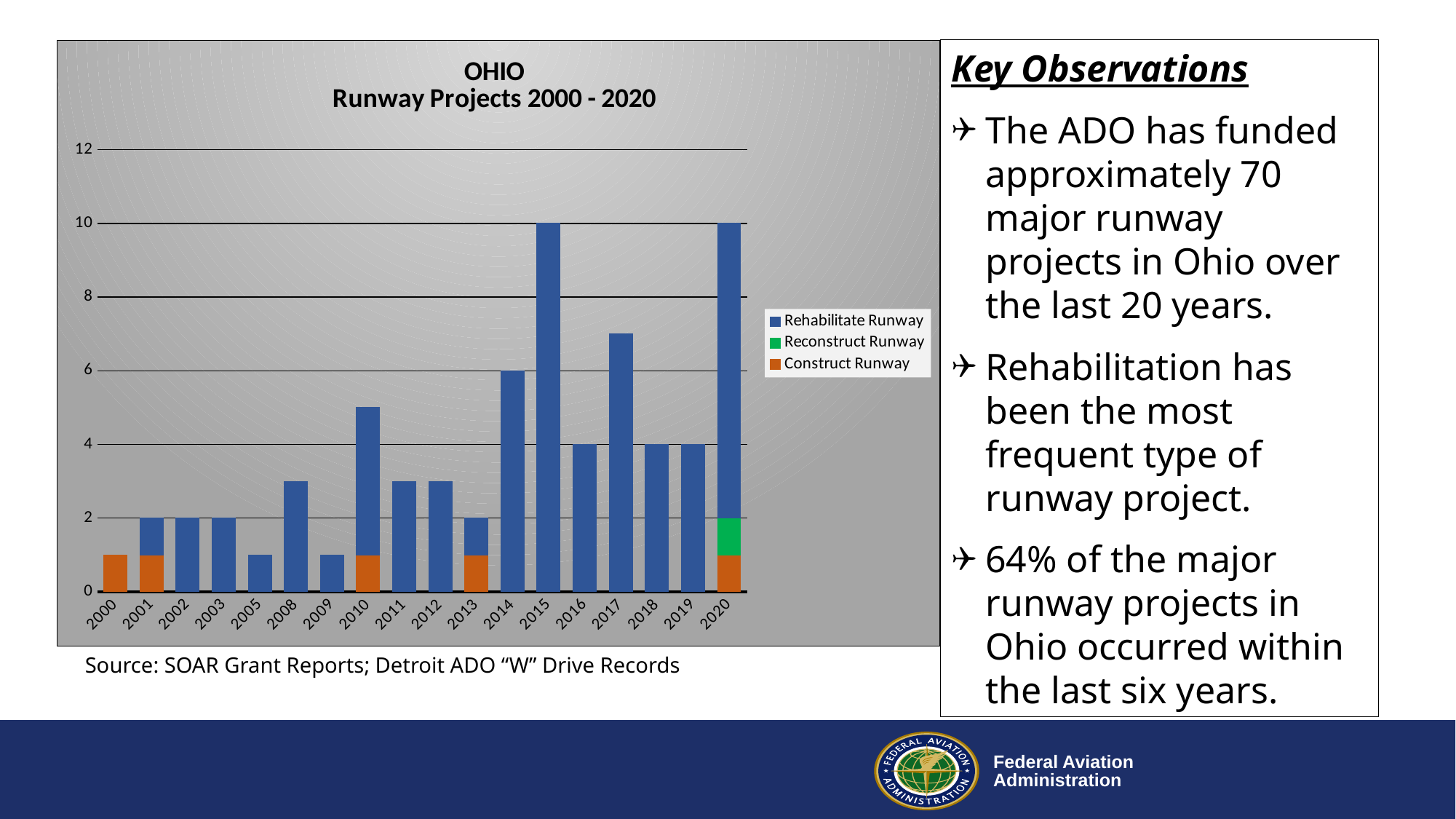
What is the title of the chart? OHIO Runway Projects 2000 - 2020 What is the total number of runway projects in 2020? 10 How many series does the legend list? 3 Is the total value for 2008 greater or less than 4? less What is the difference between the total projects in 2015 and 2014? 4 How many years are shown on the x axis? 18 Which year has more runway projects, 2017 or 2016? 2017 What is the total number of runway projects in 2015? 10 What is the total number of runway projects in 2014? 6 Which series is shown in green in the legend? Reconstruct Runway Is the total value for 2017 greater or less than 6? greater What kind of chart is shown on the slide? Stacked bar chart